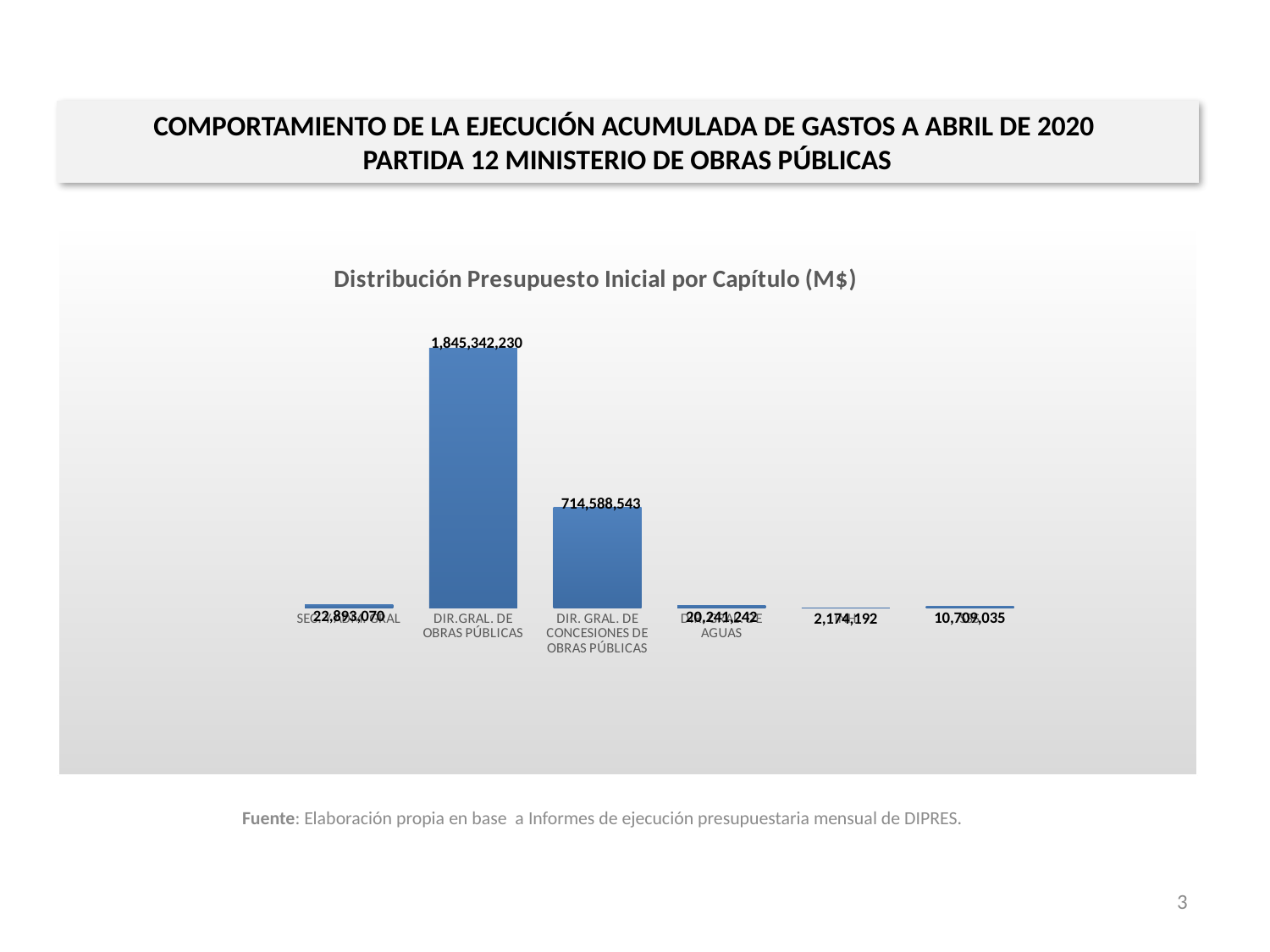
Which is larger, the value for DIR.GRAL. DE OBRAS PÚBLICAS or the value for DIR. GRAL. DE CONCESIONES DE OBRAS PÚBLICAS? DIR.GRAL. DE OBRAS PÚBLICAS What is the difference between the values for DIR.GRAL. DE OBRAS PÚBLICAS and DIR. GRAL. DE CONCESIONES DE OBRAS PÚBLICAS? 1,130,753,687 What is the value for DIR. GRAL. DE CONCESIONES DE OBRAS PÚBLICAS? 714,588,543 How many bars are plotted in the chart? 6 What is the largest value shown in the chart? 1,845,342,230 What is the smallest value shown in the chart? 2,174,192 What unit is indicated in the chart title? M$ What is the value for DIR.GRAL. DE OBRAS PÚBLICAS? 1,845,342,230 What is the title of the chart? Distribución Presupuesto Inicial por Capítulo (M$) What type of chart is shown on the slide? bar chart Which category has the highest value in the chart? DIR.GRAL. DE OBRAS PÚBLICAS